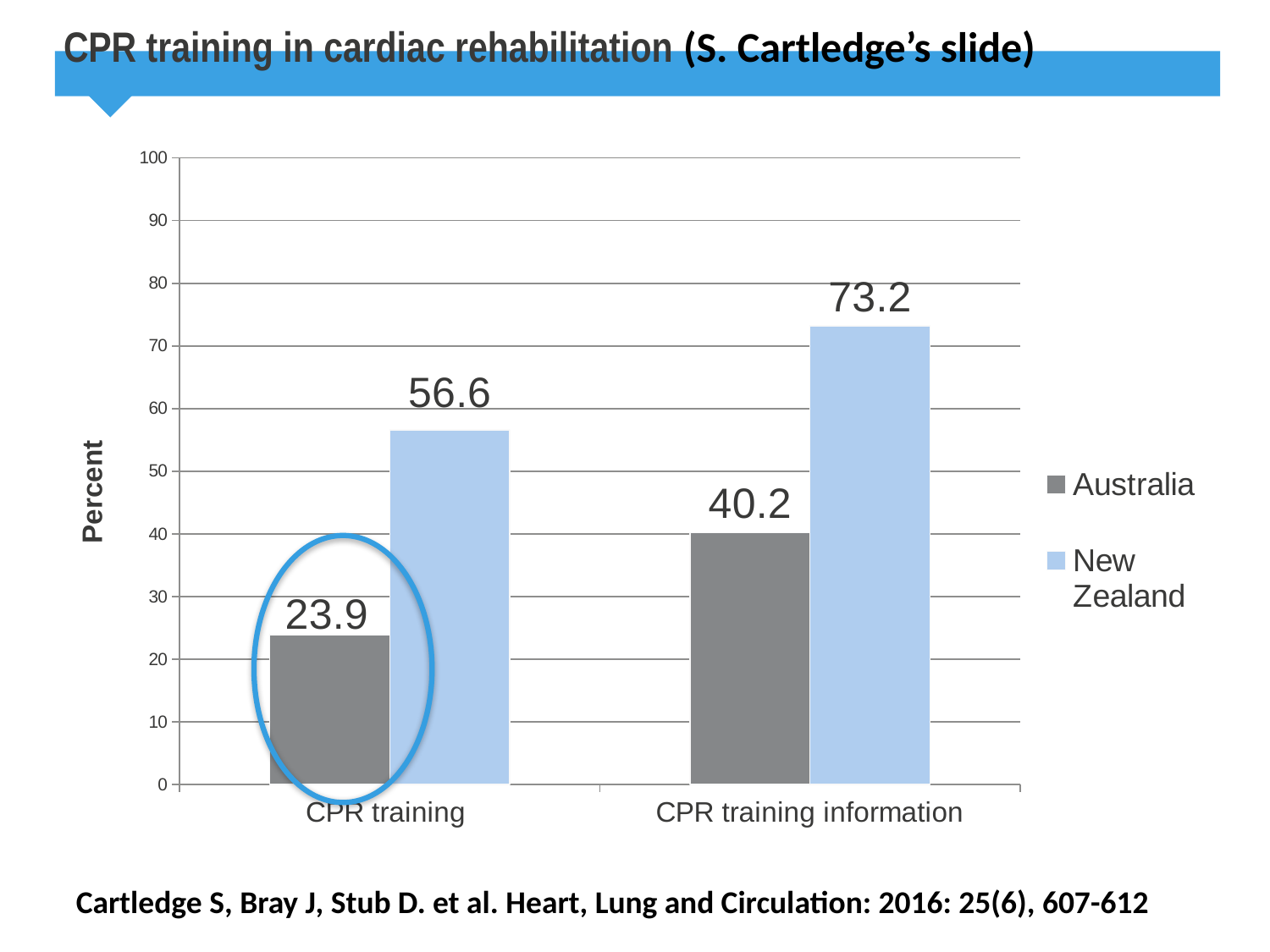
How many series does the legend list? 2 What is the difference between the New Zealand and Australia values for CPR training information? 33.0 Which bar has the highest value on the chart? New Zealand, CPR training information What is the value for Australia in the CPR training category? 23.9 Which is larger for CPR training information: Australia or New Zealand? New Zealand How many categories are shown on the x axis? 2 Which bar has the lowest value on the chart? Australia, CPR training What is the difference between the New Zealand and Australia values for CPR training? 32.7 What is the value for Australia in the CPR training information category? 40.2 What is the value for New Zealand in the CPR training category? 56.6 What is the value for New Zealand in the CPR training information category? 73.2 What kind of chart is shown on the slide? Bar chart